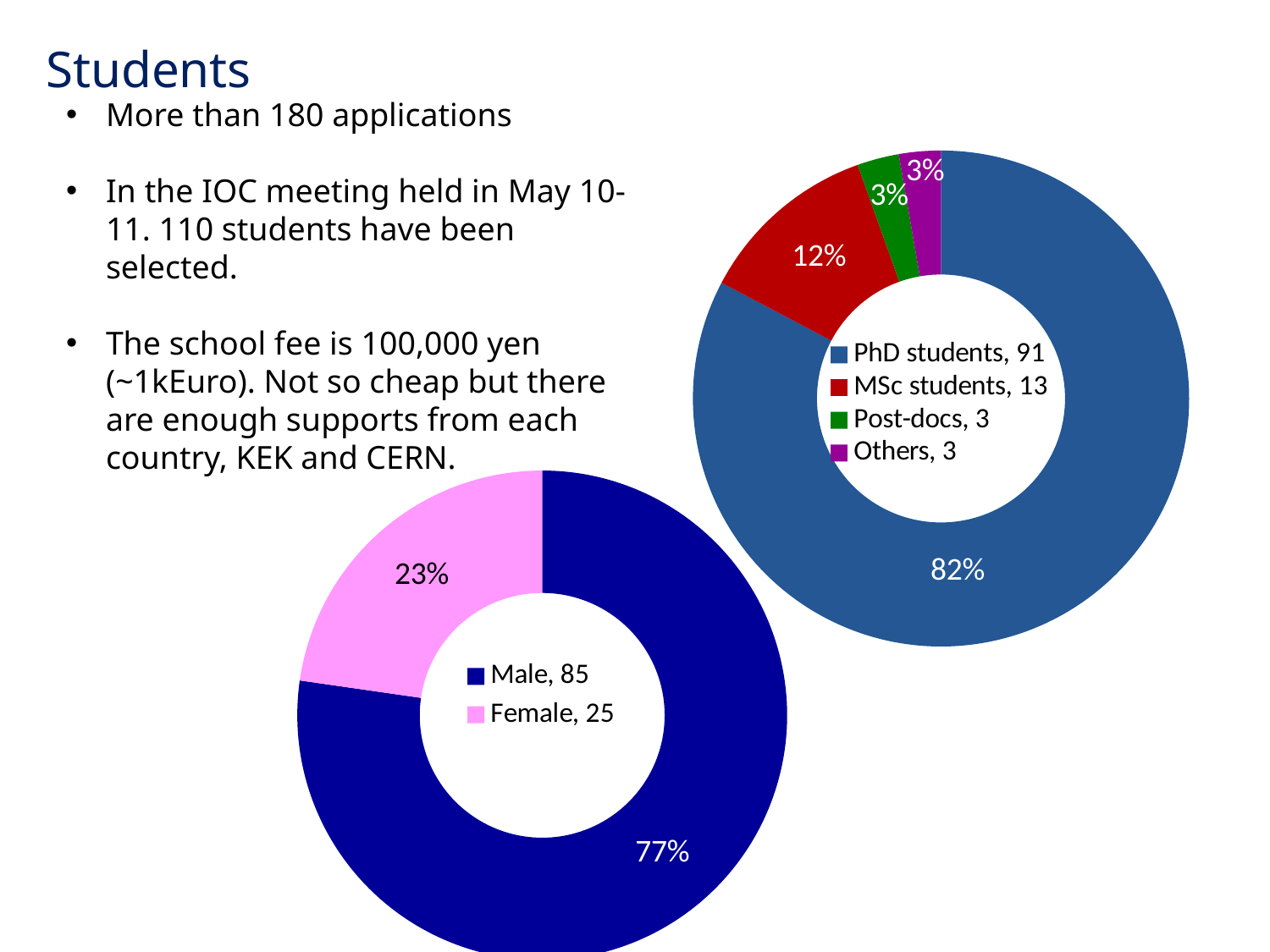
In the lower-left chart, which is larger, Male or Female? Male In the upper-right chart, how many PhD students are there according to the legend? 91 In the upper-right chart, what colour is the slice for MSc students? Red In the upper-right chart, what percentage share do MSc students have? 12% In the upper-right chart, what percentage share do Post-docs have? 3% In the upper-right chart, what is the difference between the number of PhD students and MSc students? 78 In the lower-left chart, how many Female students are there according to the legend? 25 In the upper-right chart, which category has the largest slice? PhD students In the upper-right chart, how many categories does the legend list? 4 In the lower-left chart, what is the difference between the Male and Female counts? 60 In the lower-left chart, what percentage share does Male have? 77% What kind of chart is the lower-left chart? Doughnut (pie) chart